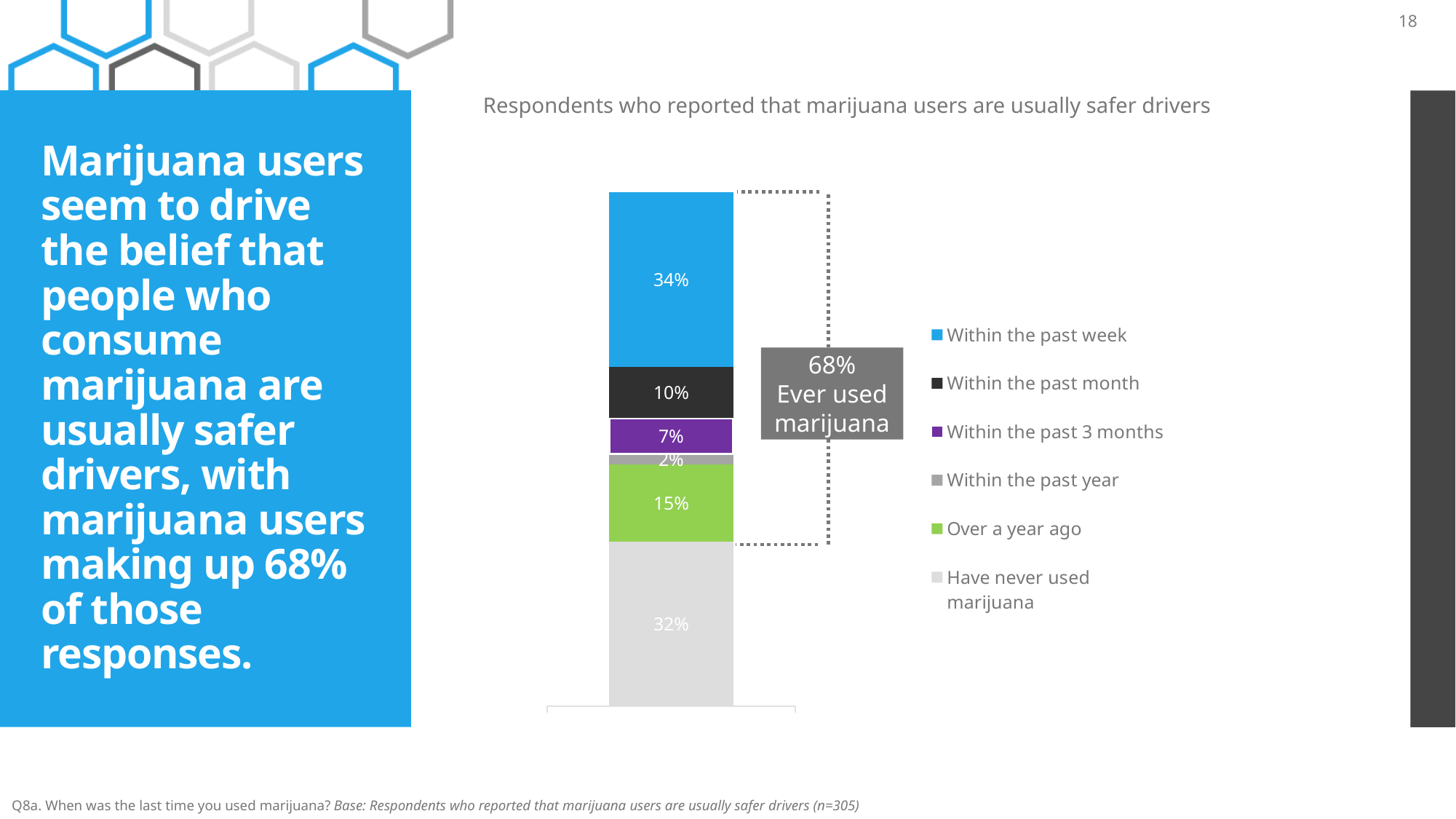
What percentage of respondents reported using marijuana over a year ago? 15% What type of chart is shown on the slide? Stacked bar chart What percentage of respondents reported using marijuana within the past month? 10% Which segment of the stacked bar has the smallest value? Within the past year Which segment of the stacked bar has the largest value? Within the past week Which is larger, the 'Over a year ago' segment or the 'Within the past month' segment? Over a year ago What is the difference between the 'Within the past week' and 'Have never used marijuana' segments? 2% According to the annotation on the chart, what percentage of respondents have ever used marijuana? 68% What percentage of respondents have never used marijuana? 32% How many segments make up the stacked bar? 6 What percentage of respondents reported using marijuana within the past 3 months? 7% What percentage of respondents reported using marijuana within the past week? 34%